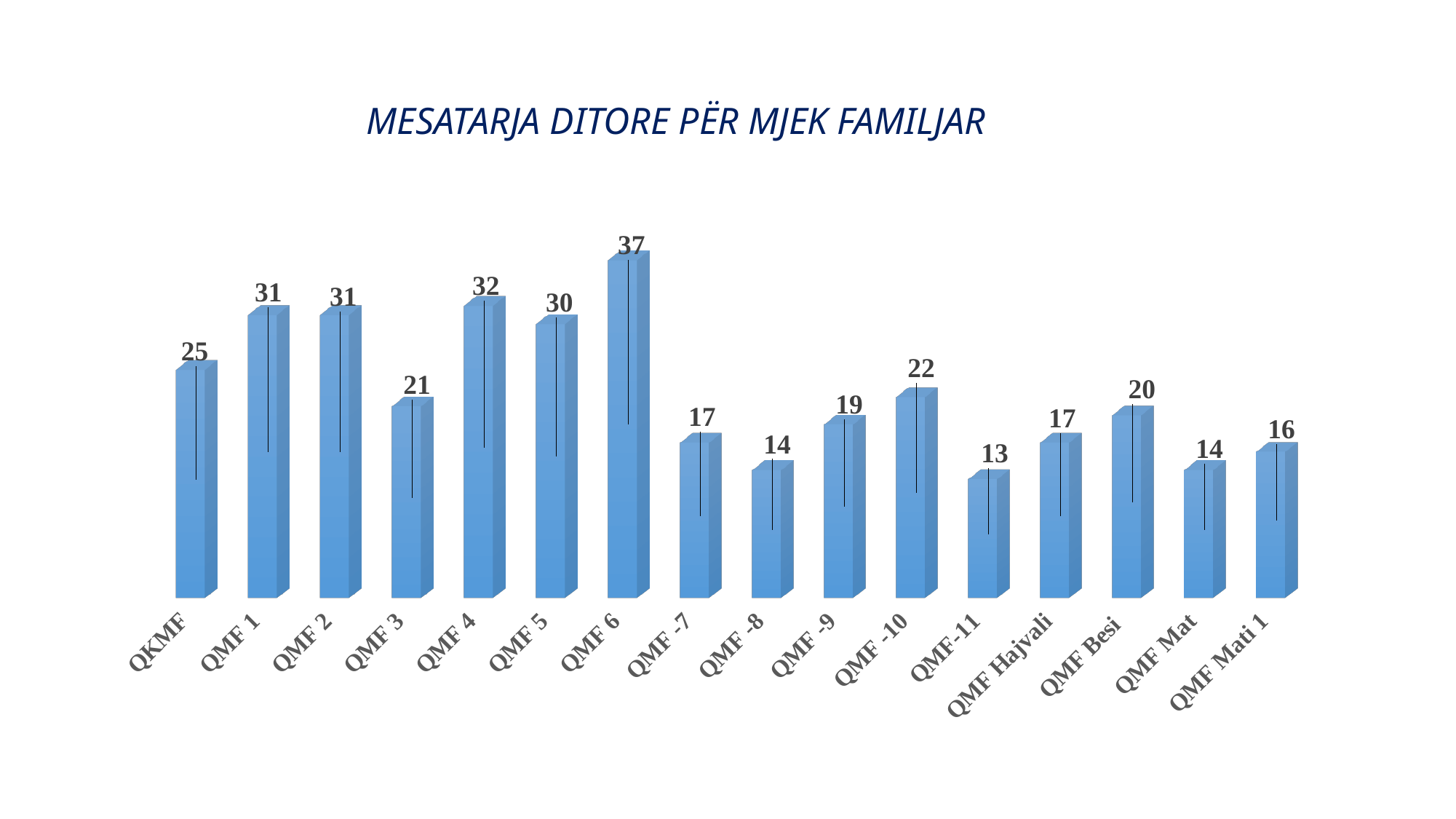
What is the title of the chart? MESATARJA DITORE PËR MJEK FAMILJAR Which category has the highest value? QMF 6 What is the value for QKMF? 25 Which is larger, the value for QMF 5 or the value for QMF -9? QMF 5 What is the value for QMF 6? 37 Which category has the lowest value? QMF-11 What kind of chart is shown on the slide? Bar chart What is the difference between the values for QMF 4 and QMF 3? 11 What is the value for QMF Hajvali? 17 Which is larger, the value for QMF -10 or the value for QMF Besi? QMF -10 How many categories are shown in the chart? 16 What is the difference between the values for QMF 6 and QMF-11? 24